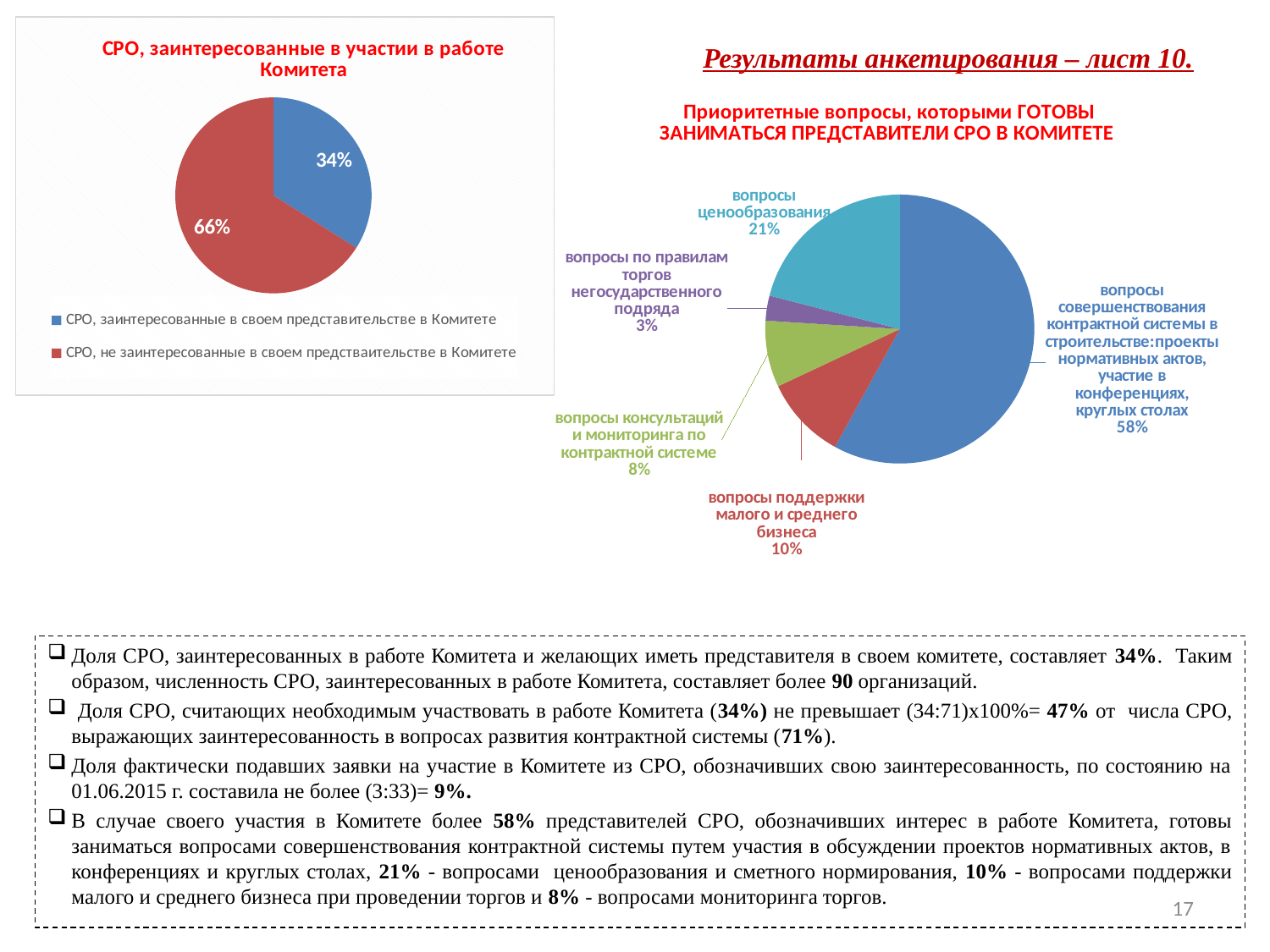
What kind of chart is the chart on the left of the slide? Pie chart In the left pie chart, what is the difference between the 66% slice and the 34% slice? 32% In the right pie chart, which category has the largest slice? вопросы совершенствования контрактной системы в строительстве (58%) In the left pie chart, how many entries does the legend list? 2 In the right pie chart, which is larger: 'вопросы консультаций и мониторинга по контрактной системе' or 'вопросы поддержки малого и среднего бизнеса'? вопросы поддержки малого и среднего бизнеса In the left pie chart 'СРО, заинтересованные в участии в работе Комитета', what share is shown for 'СРО, заинтересованные в своем представительстве в Комитете'? 34% In the right pie chart, what share is shown for 'вопросы по правилам торгов негосударственного подряда'? 3% In the right pie chart, what share is shown for 'вопросы поддержки малого и среднего бизнеса'? 10% In the right pie chart, which category has the smallest slice? вопросы по правилам торгов негосударственного подряда (3%) In the right pie chart, how many categories (slices) are shown? 5